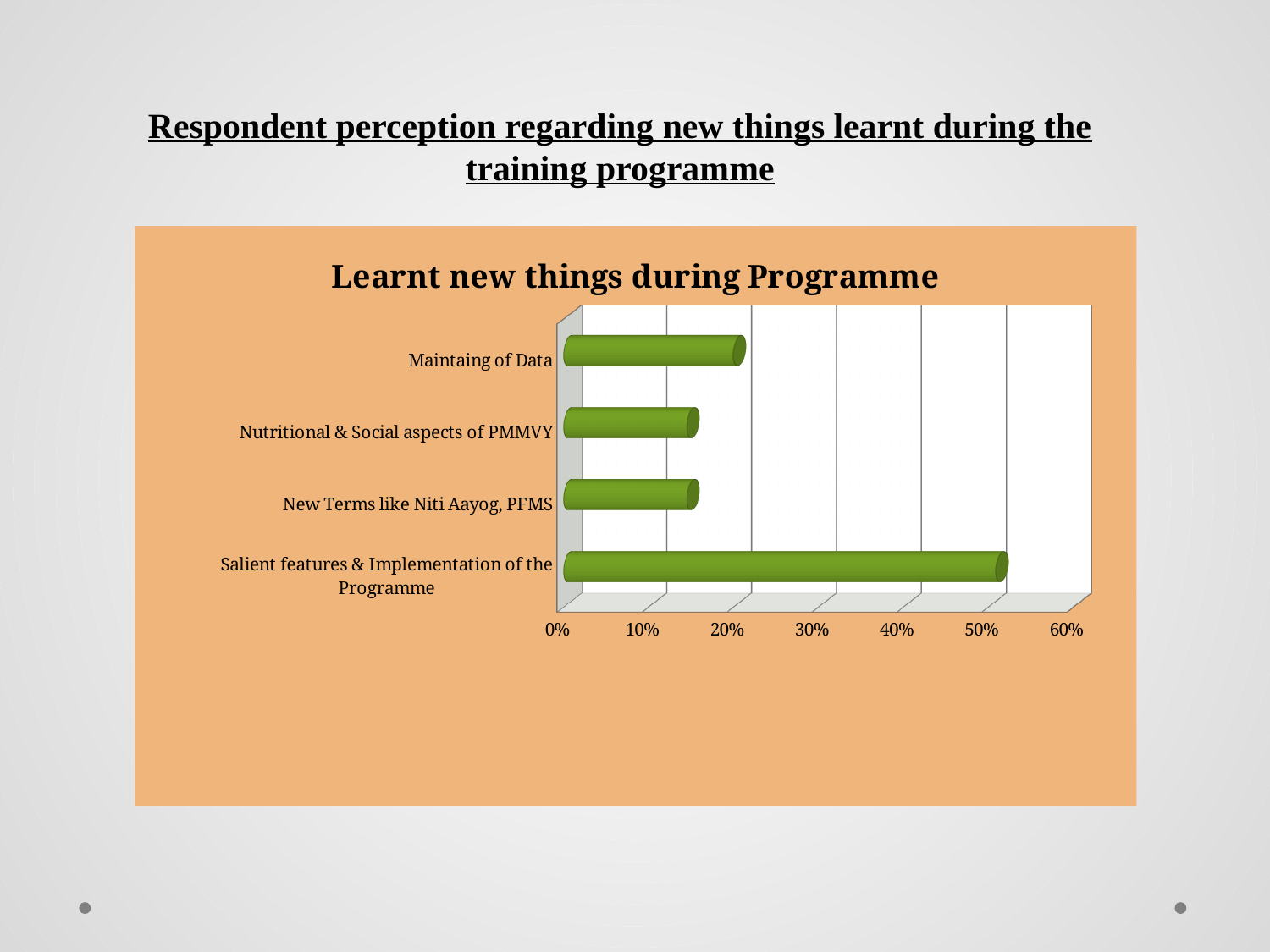
Is the value for Maintaing of Data greater or less than 30%? less Is the value for Nutritional & Social aspects of PMMVY greater or less than 20%? less What colour are the bars in the chart? green What is the maximum value shown on the horizontal axis? 60% How many categories are plotted in the chart? 4 What kind of chart is shown on the slide? bar chart Which is larger: the value for Maintaing of Data or the value for Nutritional & Social aspects of PMMVY? Maintaing of Data Is the value for New Terms like Niti Aayog, PFMS greater or less than 10%? greater What is the title of the chart? Learnt new things during Programme Which category has the highest value? Salient features & Implementation of the Programme Which is larger: the value for Salient features & Implementation of the Programme or the value for Maintaing of Data? Salient features & Implementation of the Programme